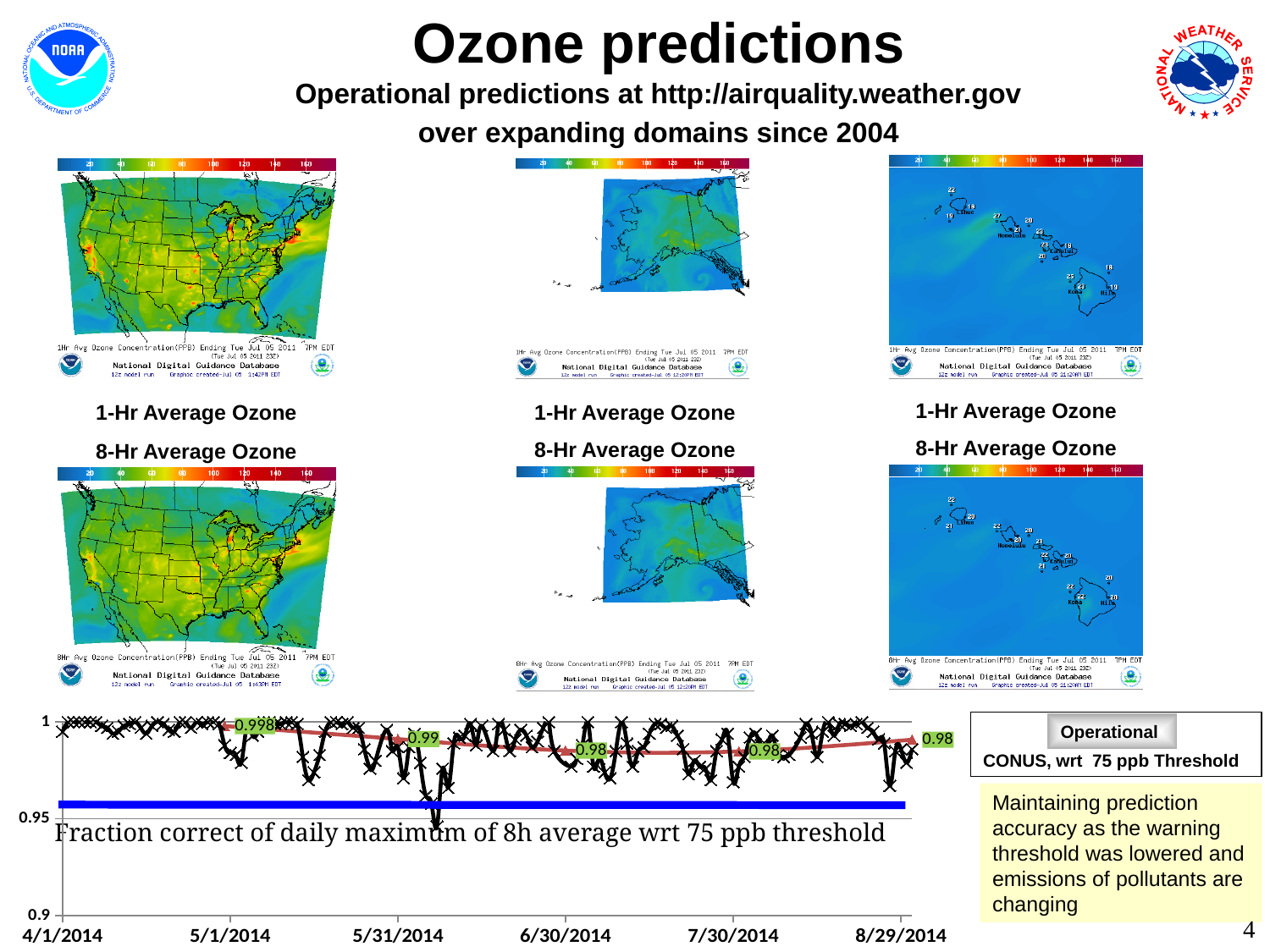
In the bottom line chart, what is the lowest labeled value on the red trend line? 0.98 In the bottom line chart, what is the difference between the first labeled value (0.998) and the last labeled value (0.98) on the red trend line? 0.018 In the bottom line chart, what is the highest labeled value on the red trend line? 0.998 In the bottom line chart, what is the labeled value on the red trend line near 5/31/2014? 0.99 In the bottom line chart, does the red trend line rise or fall from 4/1/2014 to 8/29/2014? fall In the bottom line chart, is the lowest dip of the black line (near 5/31/2014) greater or less than 0.95? less In the bottom line chart, what is the highest value shown on the y axis? 1 What kind of chart is shown at the bottom of the slide? line chart In the bottom line chart, what is the first labeled value on the red trend line, near the start of the period? 0.998 According to the text on the bottom chart, what ppb threshold is the fraction correct measured against? 75 ppb In the bottom line chart, what is the last labeled value on the red trend line, near 8/29/2014? 0.98 In the bottom line chart, how many date labels are shown on the x axis? 6